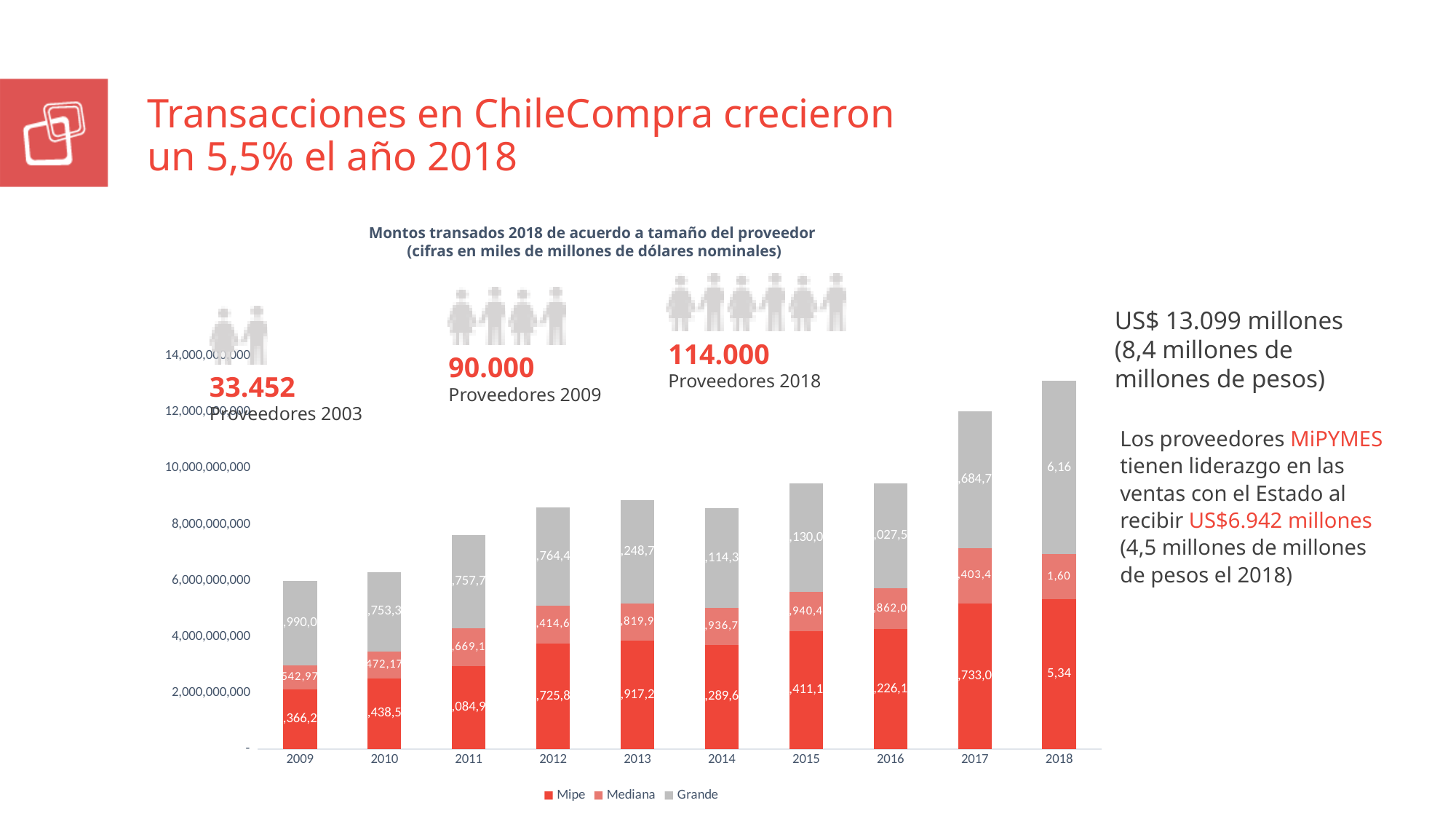
Which year has the lowest total bar in the chart? 2009 Is the total bar for 2017 greater or less than 10,000,000,000? greater Which year has the larger total bar, 2017 or 2016? 2017 Is the total bar for 2009 greater or less than 8,000,000,000? less Do the total bar values generally rise or fall from 2009 to 2018? rise How many years are shown on the x axis of the chart? 10 Which year has the highest total bar in the chart? 2018 What are the three series named in the chart legend? Mipe, Mediana, Grande Is the total bar for 2018 greater or less than 12,000,000,000? greater What kind of chart is shown on the slide? Stacked bar chart How many series does the chart legend list? 3